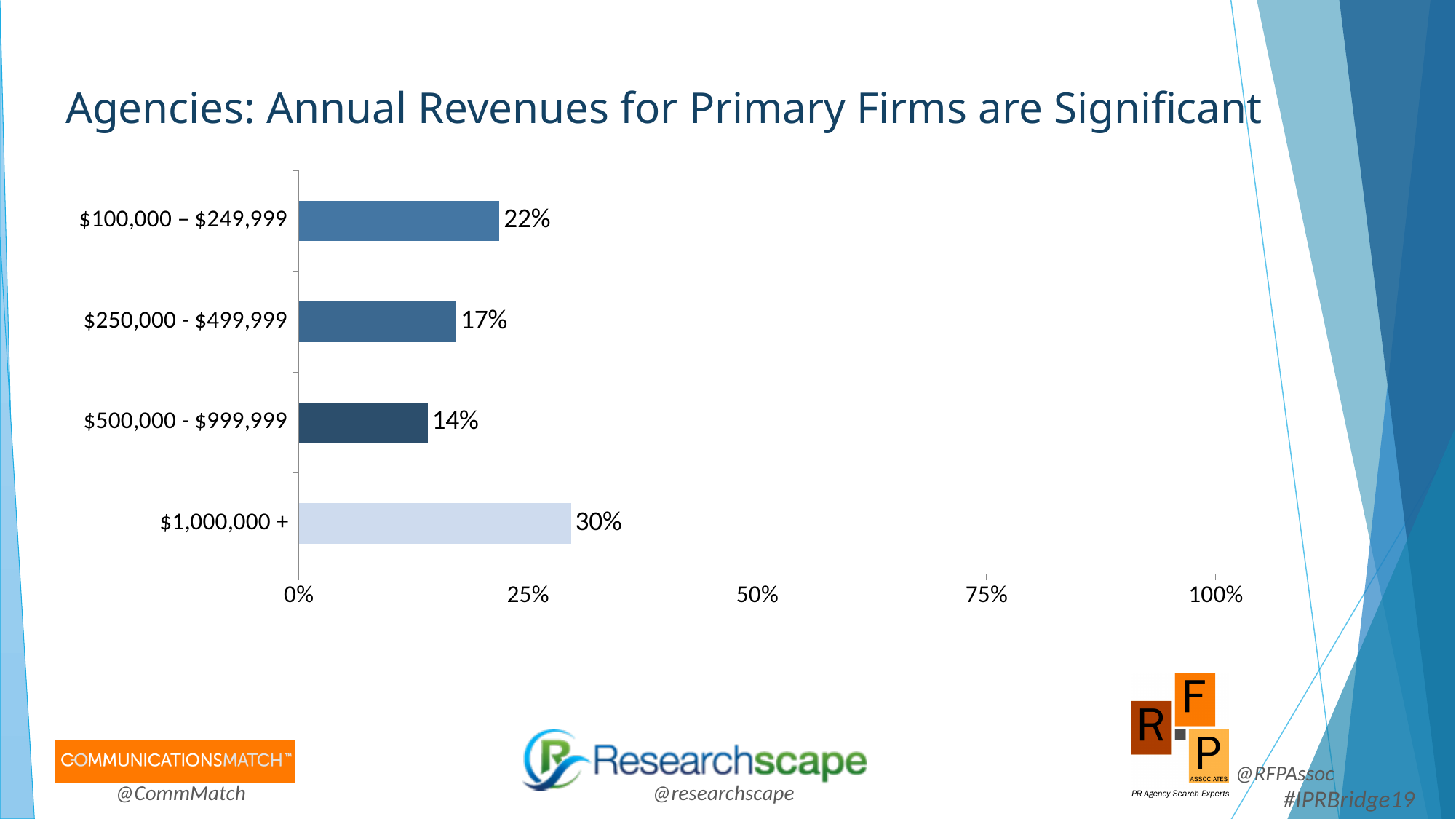
Which revenue category has the lowest percentage? $500,000 - $999,999 Is the value for $1,000,000 + greater or less than 25%? greater What is the difference in percentage points between the $1,000,000 + category and the $500,000 - $999,999 category? 16 percentage points What kind of chart is shown on the slide? Bar chart Which is larger: the value for $100,000 – $249,999 or the value for $250,000 - $499,999? $100,000 – $249,999 How many revenue categories are shown in the chart? 4 What percentage of primary firms have annual revenues of $100,000 – $249,999? 22% What percentage of primary firms have annual revenues of $250,000 - $499,999? 17% What percentage of primary firms have annual revenues of $1,000,000 +? 30% What percentage of primary firms have annual revenues of $500,000 - $999,999? 14% What is the title of the slide containing the chart? Agencies: Annual Revenues for Primary Firms are Significant Which revenue category has the highest percentage? $1,000,000 +